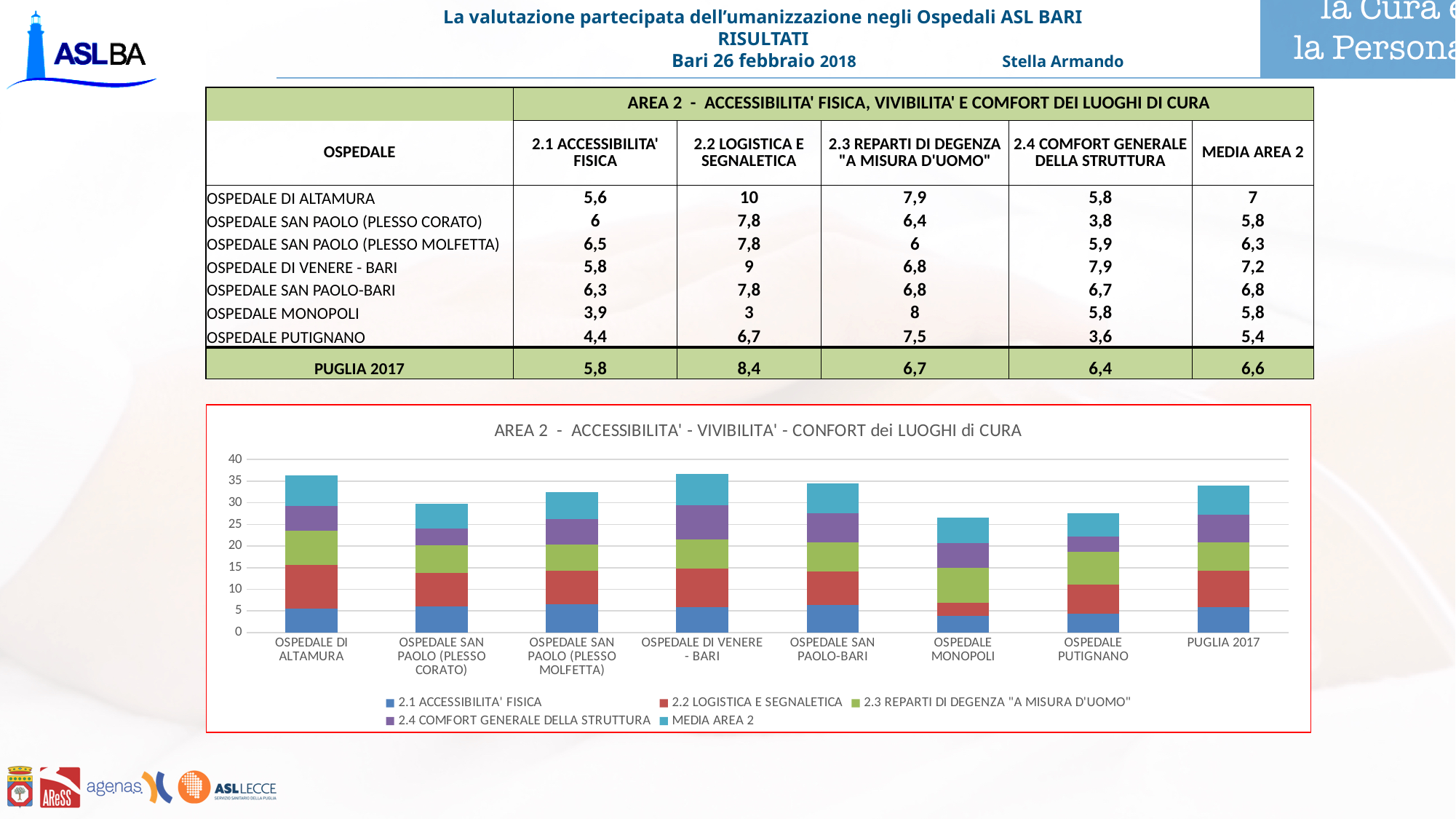
What is the difference in 2.4 COMFORT GENERALE DELLA STRUTTURA between OSPEDALE DI VENERE - BARI and OSPEDALE PUTIGNANO? 4,3 How many series does the chart legend list? 5 Which has the larger 2.2 LOGISTICA E SEGNALETICA value, OSPEDALE DI ALTAMURA or OSPEDALE MONOPOLI? OSPEDALE DI ALTAMURA Which category has the lowest value for 2.2 LOGISTICA E SEGNALETICA? OSPEDALE MONOPOLI What is the value of 2.2 LOGISTICA E SEGNALETICA for OSPEDALE DI ALTAMURA? 10 What is the total of the stacked bar for OSPEDALE MONOPOLI? 26,5 How many categories are shown along the x axis of the chart? 8 What kind of chart is shown on the slide? Stacked bar chart Is the total stacked bar for OSPEDALE MONOPOLI greater or less than 30? less What is the MEDIA AREA 2 value for OSPEDALE MONOPOLI? 5,8 What is the total of the stacked bar for OSPEDALE DI ALTAMURA? 36,3 Is the total stacked bar for OSPEDALE DI VENERE - BARI greater or less than 35? greater